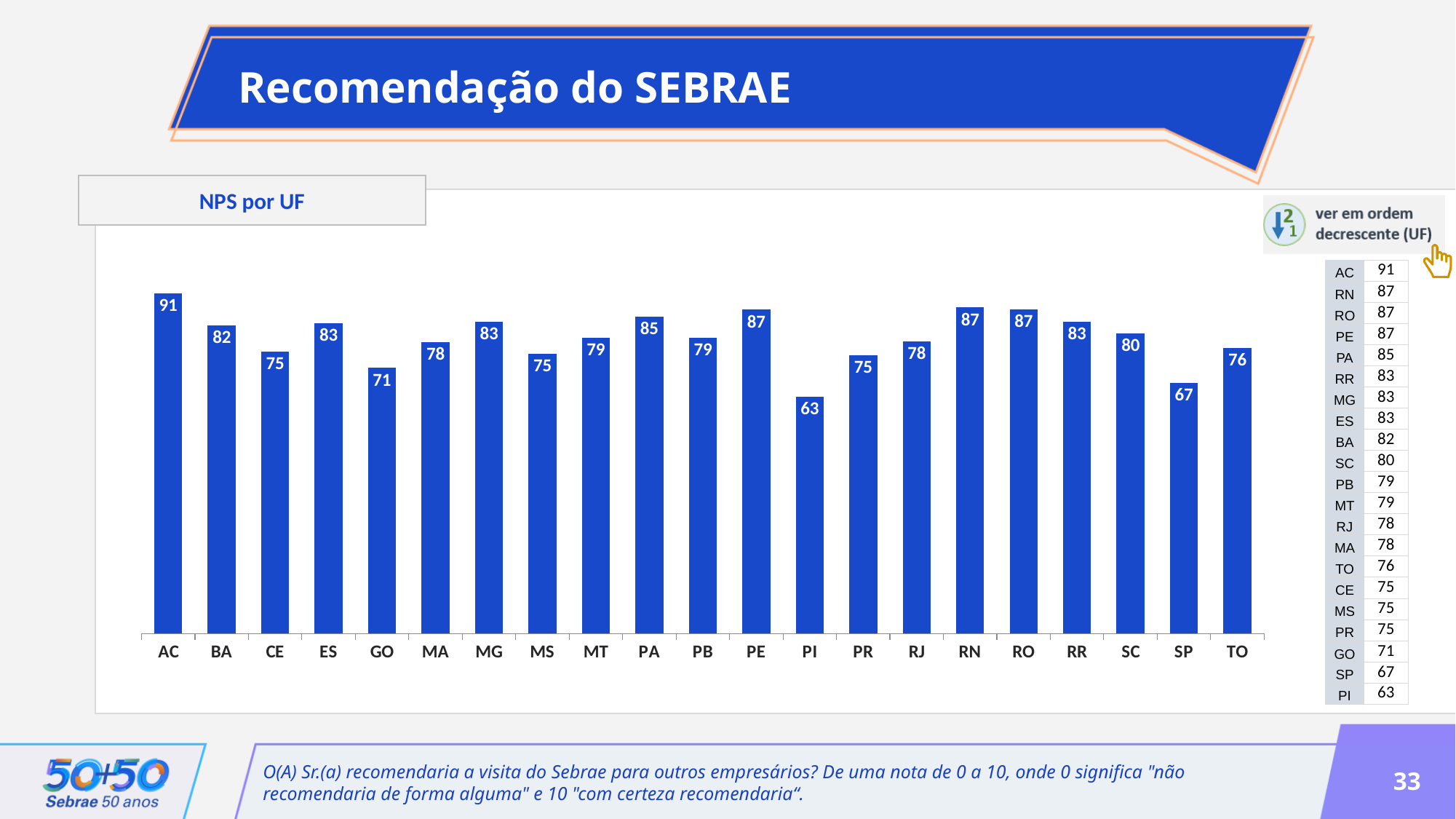
Which has a higher NPS, PE or BA? PE What is the difference between the NPS of PA and the NPS of GO? 14 What is the NPS value for AC in the 'NPS por UF' chart? 91 What is the difference between the NPS of AC and the NPS of PI? 28 What is the title of the chart on the slide? NPS por UF What is the NPS value for SC in the 'NPS por UF' chart? 80 What kind of chart is used to show NPS por UF? Bar chart Which UF has the lowest NPS in the 'NPS por UF' chart? PI What is the NPS value for PI in the 'NPS por UF' chart? 63 How many UFs (bars) are shown in the 'NPS por UF' chart? 21 Which UF has the highest NPS in the 'NPS por UF' chart? AC Which has a higher NPS, SP or TO? TO